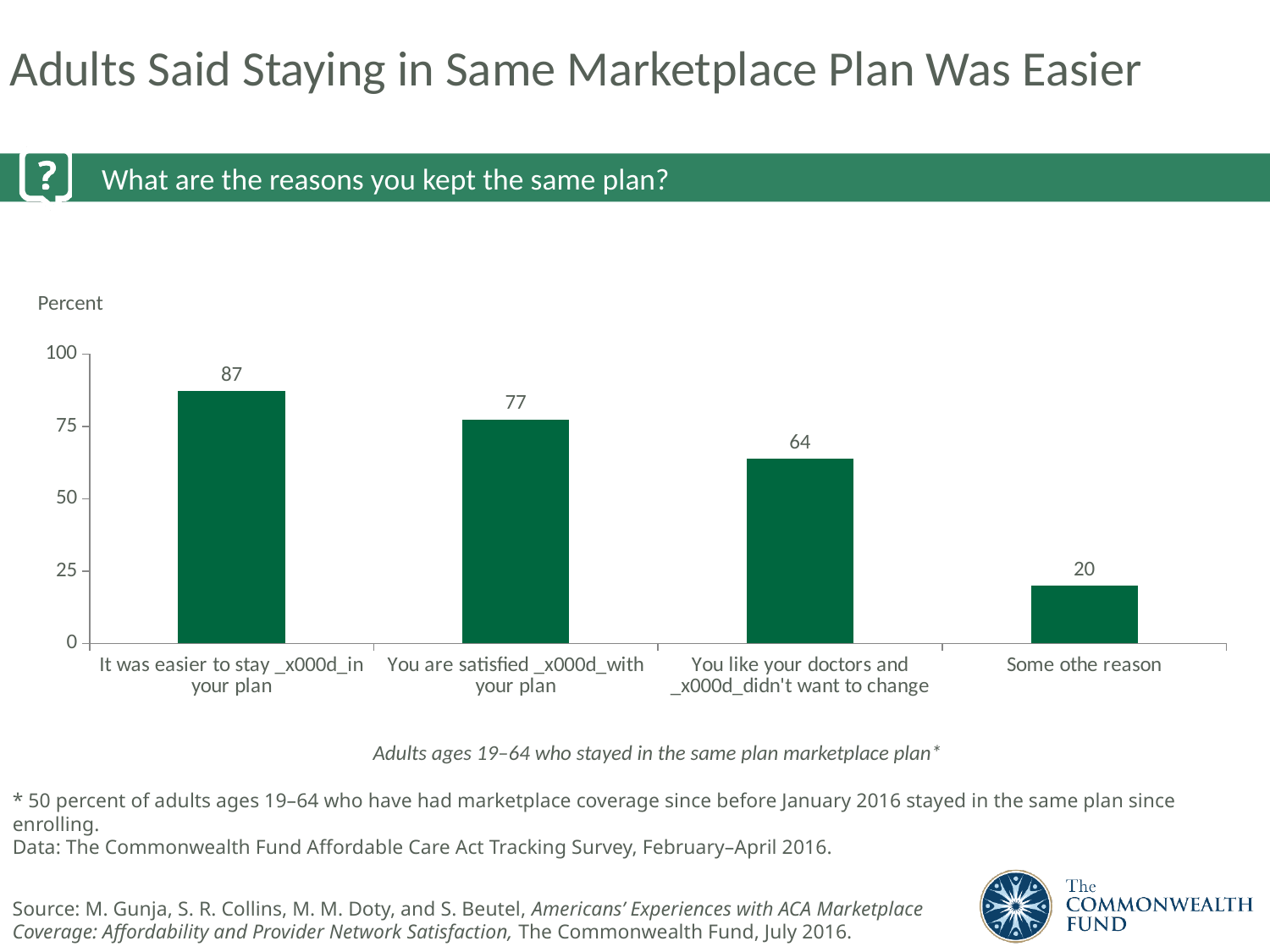
What kind of chart is shown on the slide? Bar chart Which reason for keeping the same plan has the lowest percentage? Some other reason What percent of adults said it was easier to stay in their plan? 87 What is the difference in percentage points between 'It was easier to stay in your plan' and 'Some other reason'? 67 Which reason for keeping the same plan has the highest percentage? It was easier to stay in your plan What percent of adults said they are satisfied with their plan? 77 Which is larger: the percentage for 'You are satisfied with your plan' or for 'You like your doctors and didn't want to change'? You are satisfied with your plan What percent of adults gave some other reason for keeping the same plan? 20 Do the values rise or fall moving from left to right across the bars? Fall What is the difference in percentage points between 'You are satisfied with your plan' and 'You like your doctors and didn't want to change'? 13 What percent of adults said they like their doctors and didn't want to change? 64 How many reasons (bars) are shown in the chart? 4